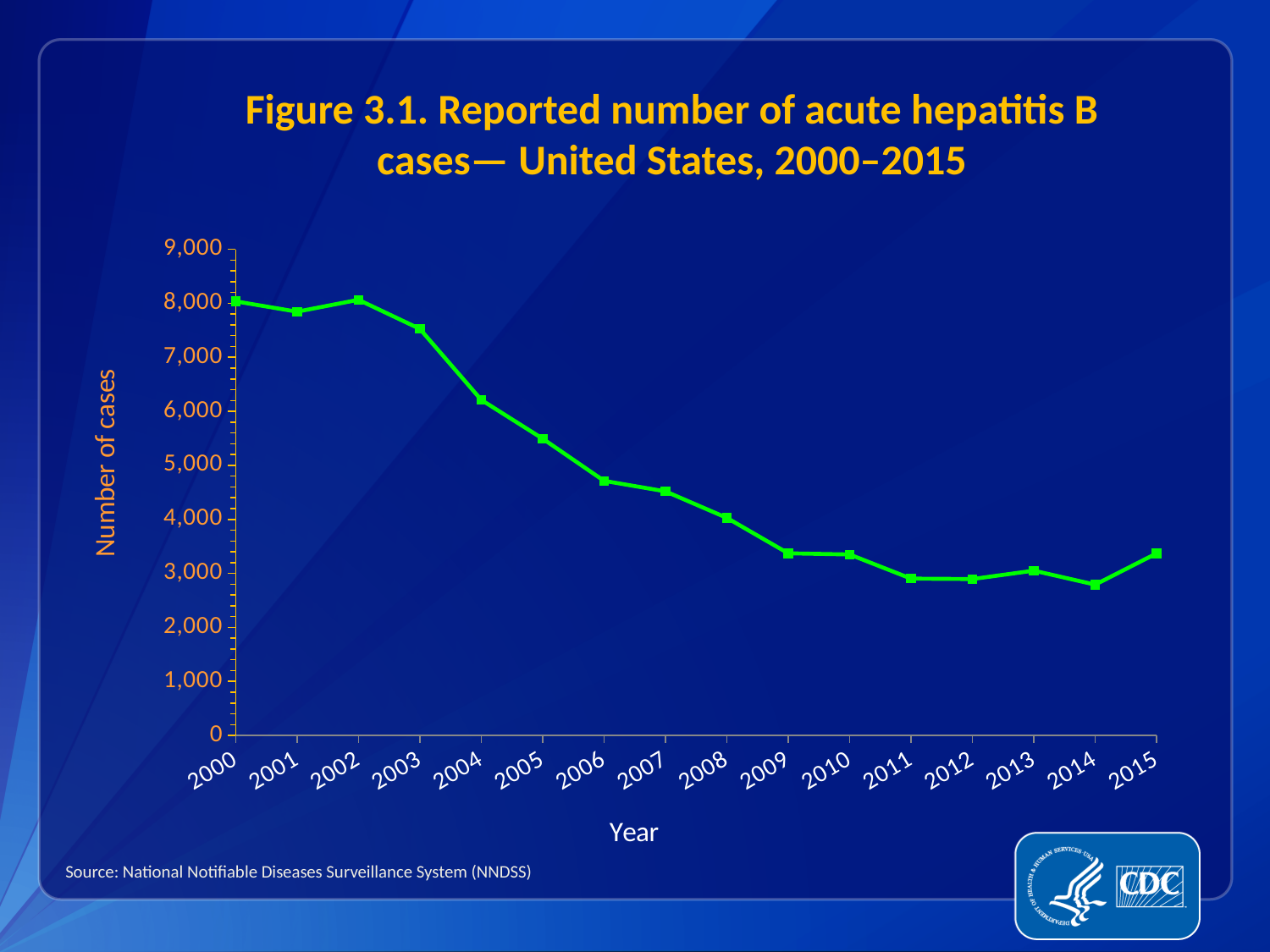
What is the label of the y axis? Number of cases What is the title of the chart? Figure 3.1. Reported number of acute hepatitis B cases— United States, 2000–2015 How many years are plotted on the x axis? 16 Is the number of cases for 2015 greater or less than 3,000? greater What kind of chart is shown on the slide? line chart Is the number of cases for 2003 greater or less than 7,000? greater Which year has more reported cases, 2003 or 2006? 2003 Is the number of cases for 2006 greater or less than 5,000? less Which year has more reported cases, 2014 or 2015? 2015 Overall, do the reported acute hepatitis B cases rise or fall from 2000 to 2015? fall